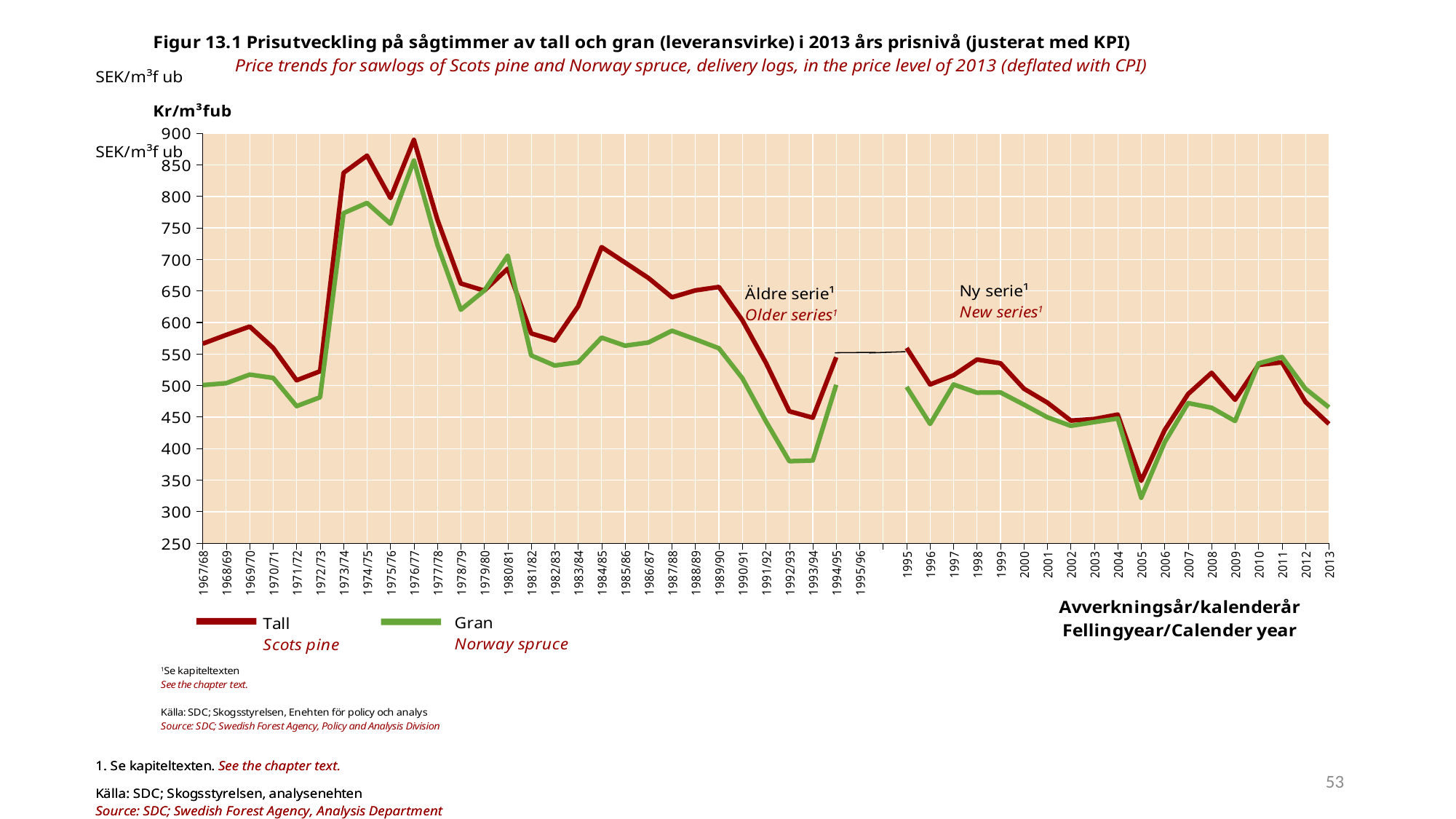
Which series has the higher value in 1980/81, Tall (Scots pine) or Gran (Norway spruce)? Gran (Norway spruce) Is the value for Gran (Norway spruce) in 2005 greater or less than 350? less Which series is drawn in green? Gran (Norway spruce) Which series has the higher value in 1984/85, Tall (Scots pine) or Gran (Norway spruce)? Tall (Scots pine) In which year does the Gran (Norway spruce) series reach its lowest value? 2005 What kind of chart is shown on the slide? Line chart Is the value for Gran (Norway spruce) in 1992/93 greater or less than 400? less In which year does the Tall (Scots pine) series reach its highest value? 1976/77 Does the Tall (Scots pine) series rise or fall from 1984/85 to 1992/93? Fall Is the value for Tall (Scots pine) in 1976/77 greater or less than 850? greater How many series does the legend list? 2